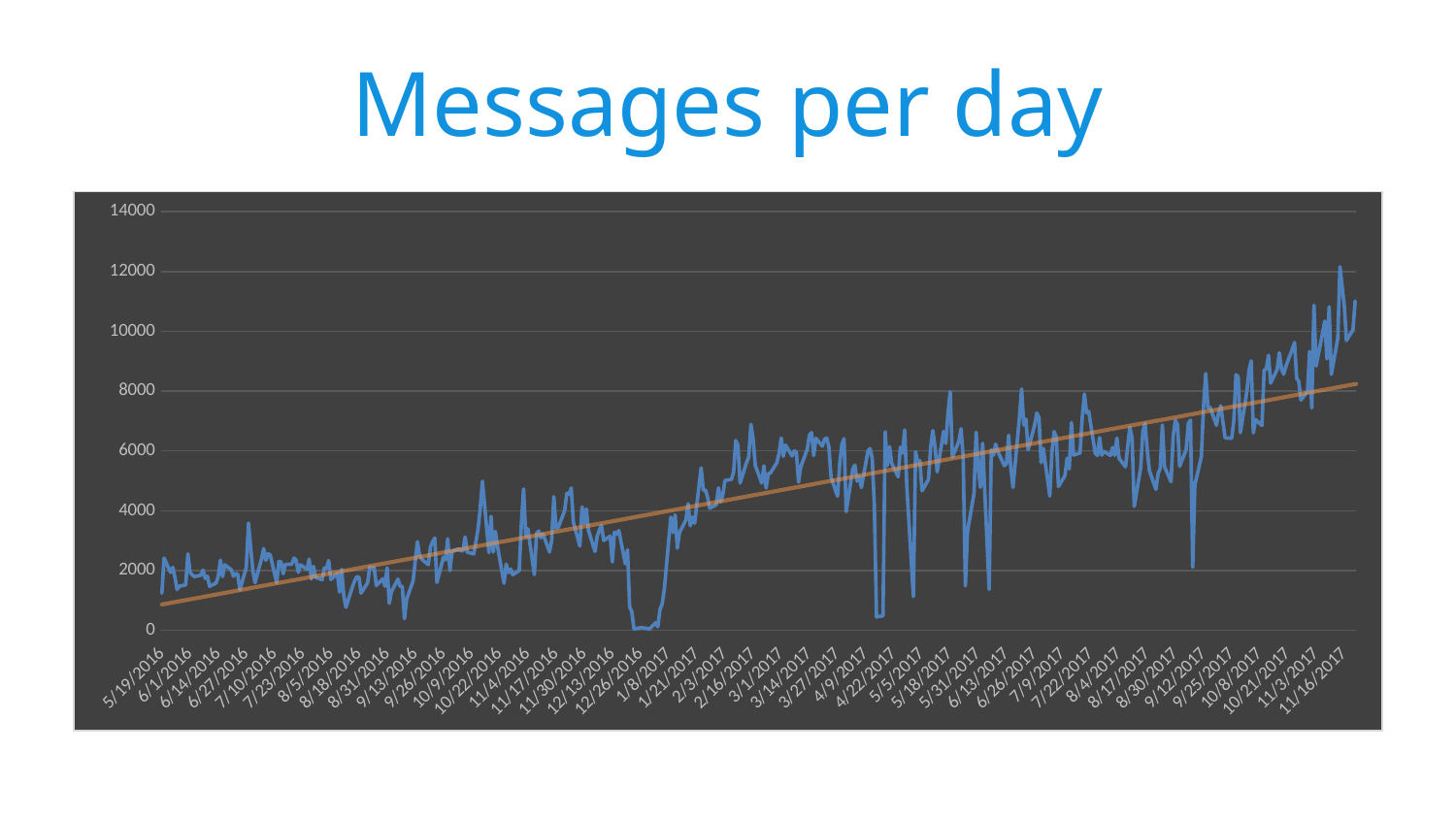
How many lines are plotted on the chart? 2 Which is larger, the value for 11/16/2017 or the value for 5/19/2016? 11/16/2017 Do the messages per day generally rise or fall from 5/19/2016 to 11/16/2017? Rise Is the value for 11/16/2017 greater or less than 8000? greater Is the value for 5/19/2016 greater or less than 4000? less What is the highest value shown on the vertical axis? 14000 Does the highest point of the blue line occur in 2016 or 2017? 2017 Is the value for 3/1/2017 greater or less than 4000? greater What is the title of the chart? Messages per day What kind of chart is shown on the slide? Line chart What is the first date label on the horizontal axis? 5/19/2016